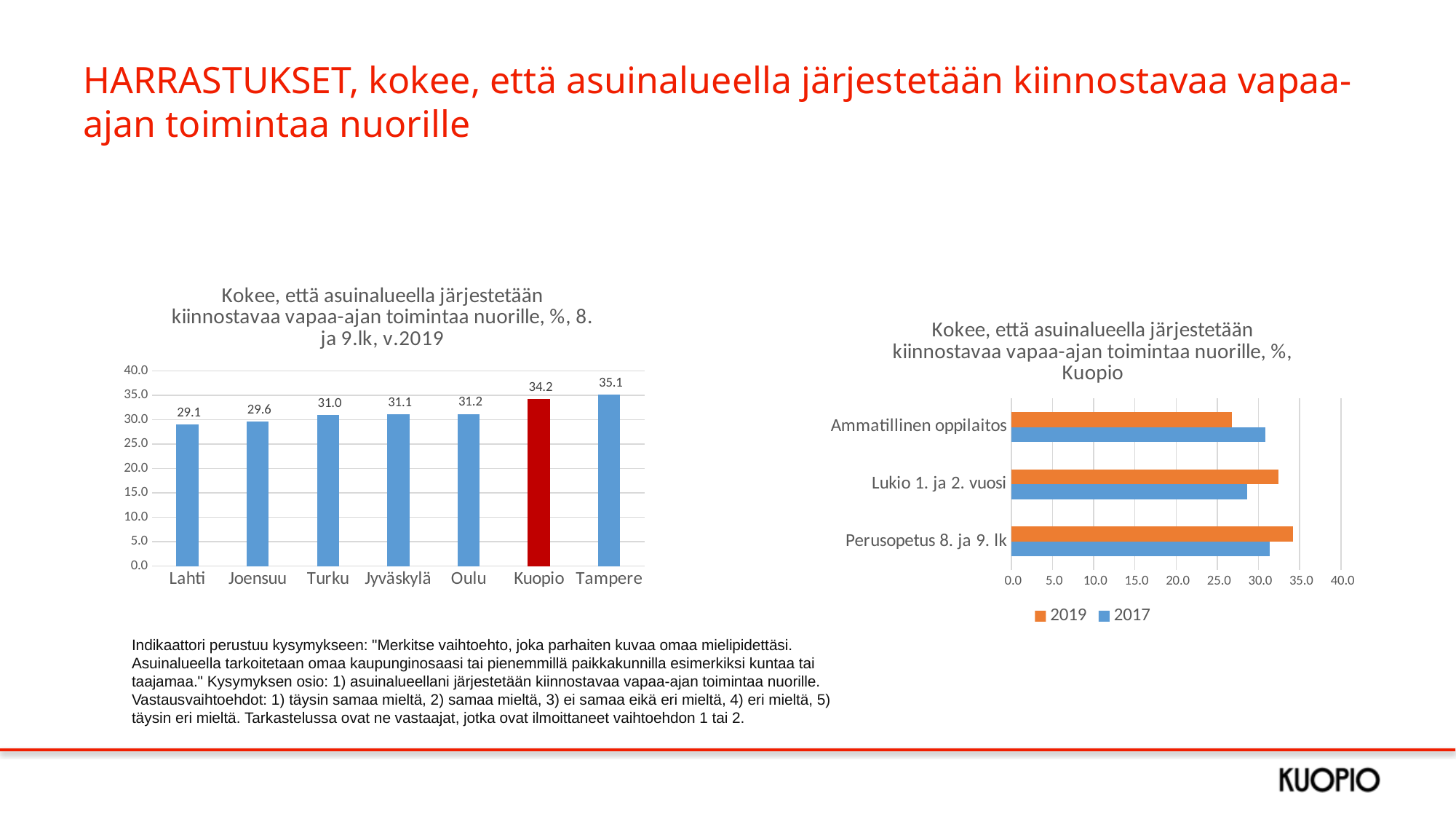
In the right chart (Kuopio), is the 2019 value for Ammatillinen oppilaitos greater or less than 30.0? less In the left chart (8. ja 9.lk, v.2019), which city has the highest value? Tampere How many series does the legend of the right chart (Kuopio) list? 2 In the left chart (8. ja 9.lk, v.2019), what is the difference between Tampere and Kuopio? 0.9 In the right chart (Kuopio), which is larger for Lukio 1. ja 2. vuosi, the 2019 value or the 2017 value? 2019 In the left chart (8. ja 9.lk, v.2019), which bar is coloured red instead of blue? Kuopio In the left chart (8. ja 9.lk, v.2019), which city has the lowest value? Lahti In the left chart (8. ja 9.lk, v.2019), which is larger, the value for Joensuu or the value for Oulu? Oulu In the left chart (8. ja 9.lk, v.2019), what is the value for Lahti? 29.1 In the left chart (8. ja 9.lk, v.2019), what is the value for Kuopio? 34.2 What type of chart is the left chart (8. ja 9.lk, v.2019)? Bar chart How many cities are shown in the left chart (8. ja 9.lk, v.2019)? 7